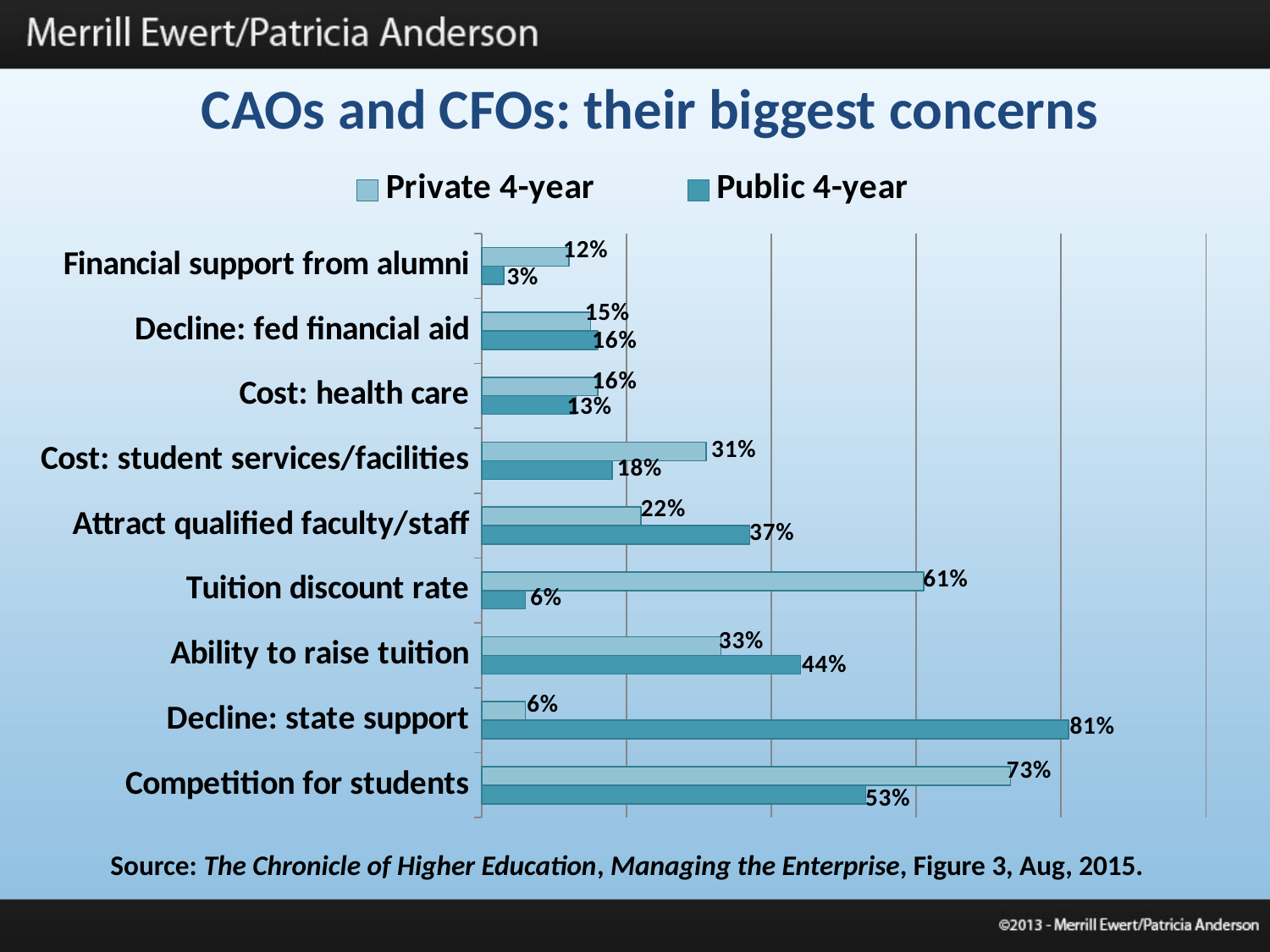
What is the difference between the Private 4-year and Public 4-year values for Competition for students? 20% For Cost: student services/facilities, which is larger: the Private 4-year or the Public 4-year value? Private 4-year What is the Private 4-year value for Tuition discount rate? 61% What is the Public 4-year value for Attract qualified faculty/staff? 37% For Ability to raise tuition, which is larger: the Private 4-year or the Public 4-year value? Public 4-year What is the difference between the Public 4-year and Private 4-year values for Decline: state support? 75% What is the Public 4-year value for Decline: state support? 81% How many categories are shown on the chart? 9 Which category has the lowest Public 4-year value? Financial support from alumni What kind of chart is shown on the slide? Bar chart Which category has the highest Private 4-year value? Competition for students How many series does the legend list? 2